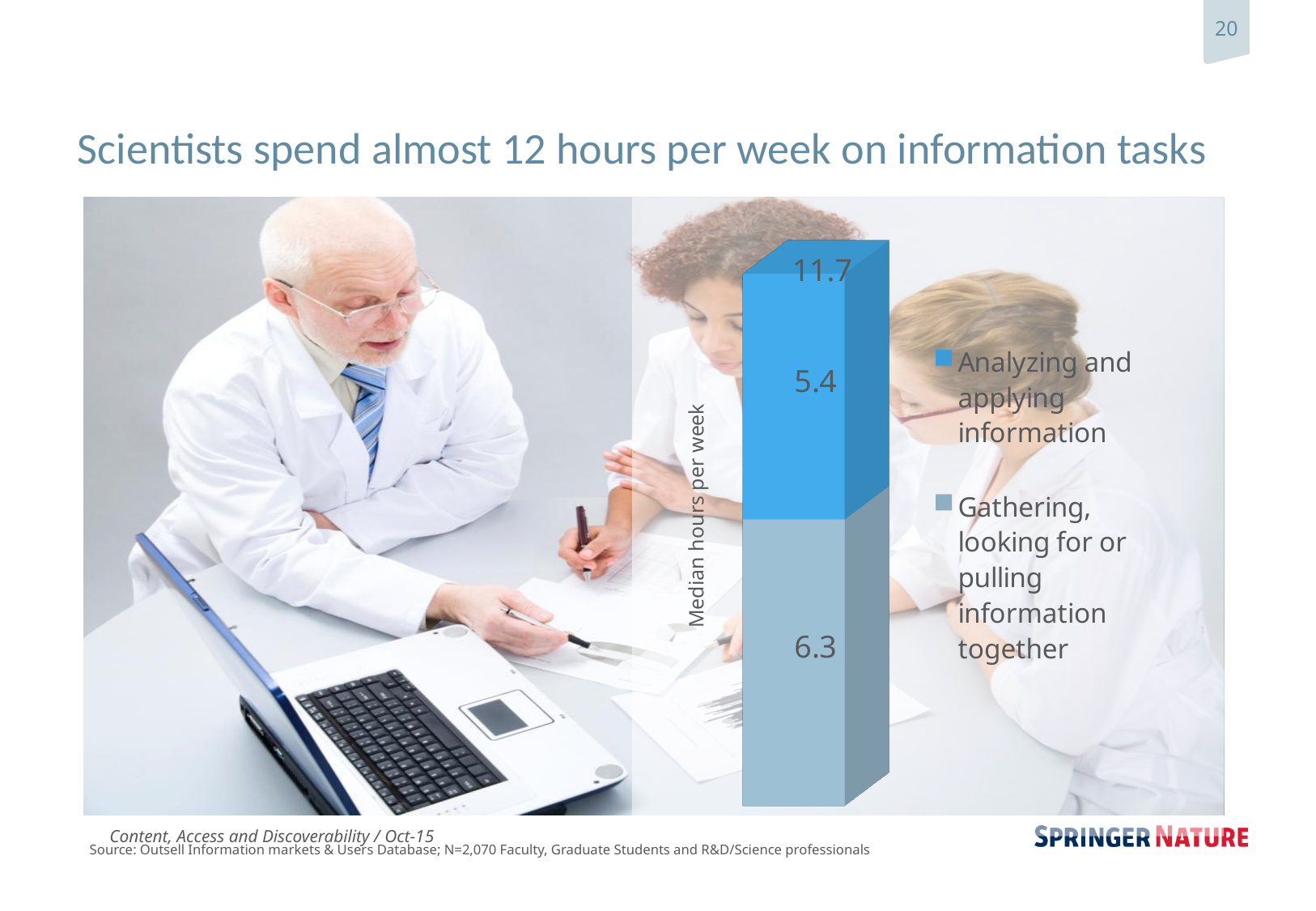
Which series has the lowest value in the stacked bar? Analyzing and applying information What is the total of the stacked bar? 11.7 What is the median hours per week for gathering, looking for or pulling information together? 6.3 What is the median hours per week for analyzing and applying information? 5.4 How many bars are plotted in the chart? 1 Which series has the highest value in the stacked bar? Gathering, looking for or pulling information together Which legend entry is shown in the darker blue colour? Analyzing and applying information What is the label on the vertical axis of the chart? Median hours per week What is the difference between the gathering segment (6.3) and the analyzing segment (5.4)? 0.9 Which segment of the stacked bar is larger: analyzing and applying information, or gathering, looking for or pulling information together? Gathering, looking for or pulling information together How many series does the legend list? 2 What kind of chart is shown on the slide? Stacked bar chart